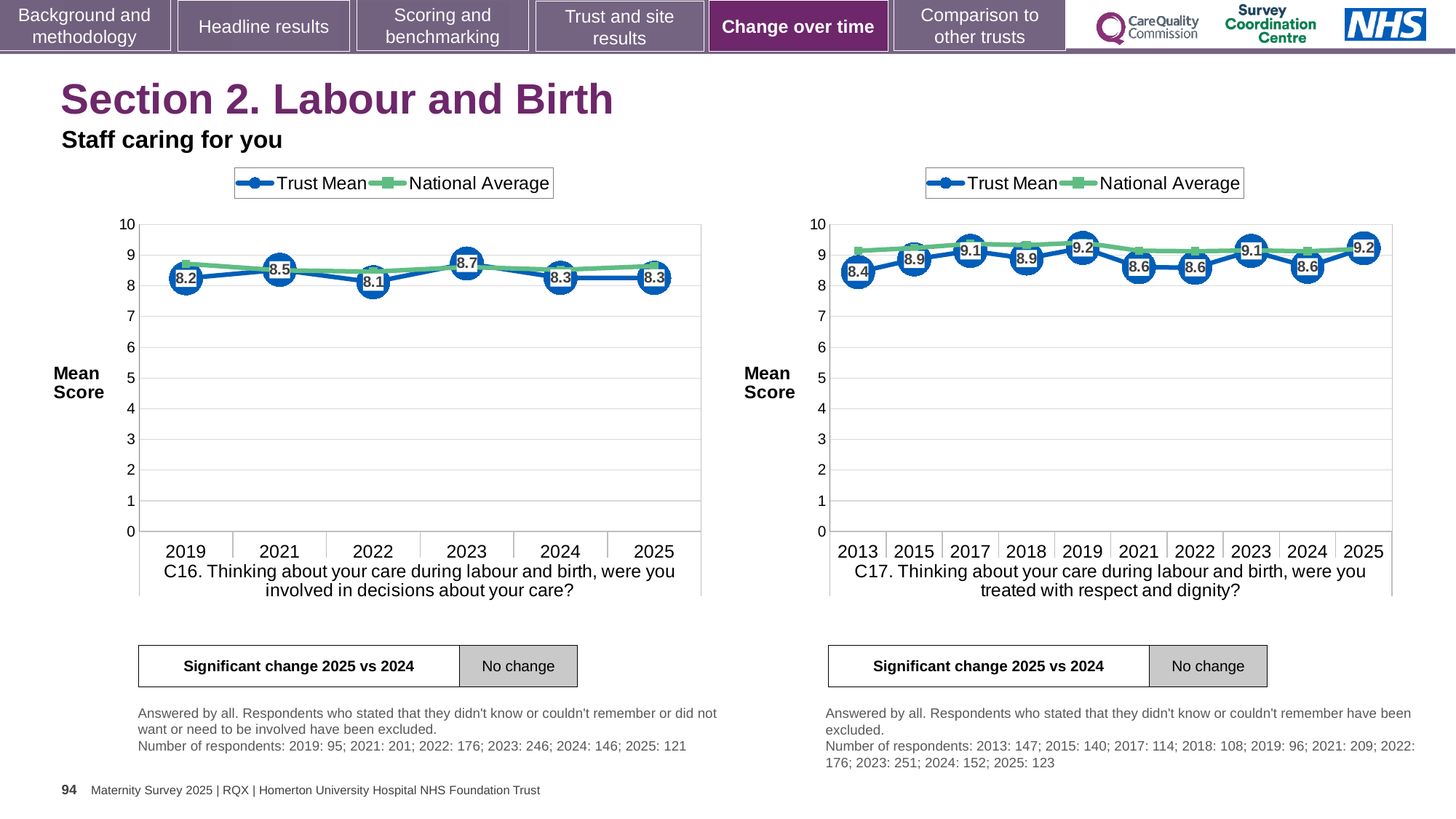
On the C17 chart (right), what is the Trust Mean for 2025? 9.2 On the C16 chart (left), what is the Trust Mean for 2019? 8.2 On the C17 chart (right), which year has the lowest Trust Mean? 2013 On the C16 chart (left), what is the difference between the Trust Mean in 2023 and in 2022? 0.6 On the C16 chart (left), which year has the lowest Trust Mean? 2022 On the C17 chart (right), what is the Trust Mean for 2013? 8.4 What type of chart is the C16 chart (left)? line chart On the C16 chart (left), which year has the highest Trust Mean? 2023 On the C16 chart (left), how many years are shown on the x axis? 6 On the C17 chart (right), is the Trust Mean for 2021 larger or smaller than the Trust Mean for 2023? smaller On the C17 chart (right), how many series does the legend list? 2 On the C16 chart (left), what is the Trust Mean for 2023? 8.7